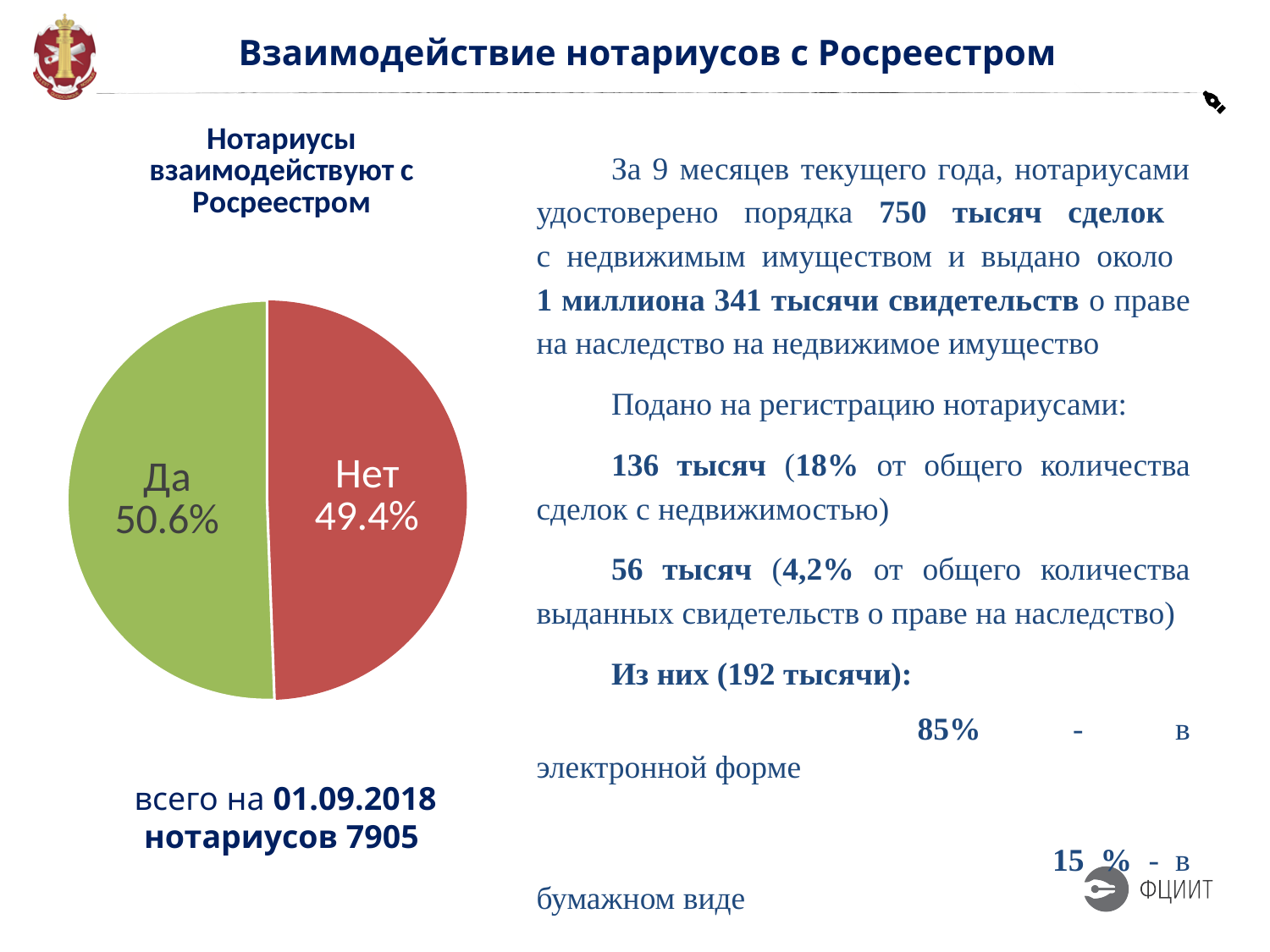
How many slices does the pie chart have? 2 Which slice of the pie chart is the smallest? Нет What share of the pie chart is labelled "Да"? 50.6% Is the share for "Нет" greater or less than 50%? less Is the share for "Да" greater or less than 50%? greater What colour is the "Да" slice of the pie chart? green Which slice of the pie chart is larger, "Да" or "Нет"? Да What kind of chart is shown on the slide? pie chart What share of the pie chart is labelled "Нет"? 49.4% What is the difference in percentage points between the "Да" and "Нет" slices? 1.2 What is the title of the pie chart? Нотариусы взаимодействуют с Росреестром